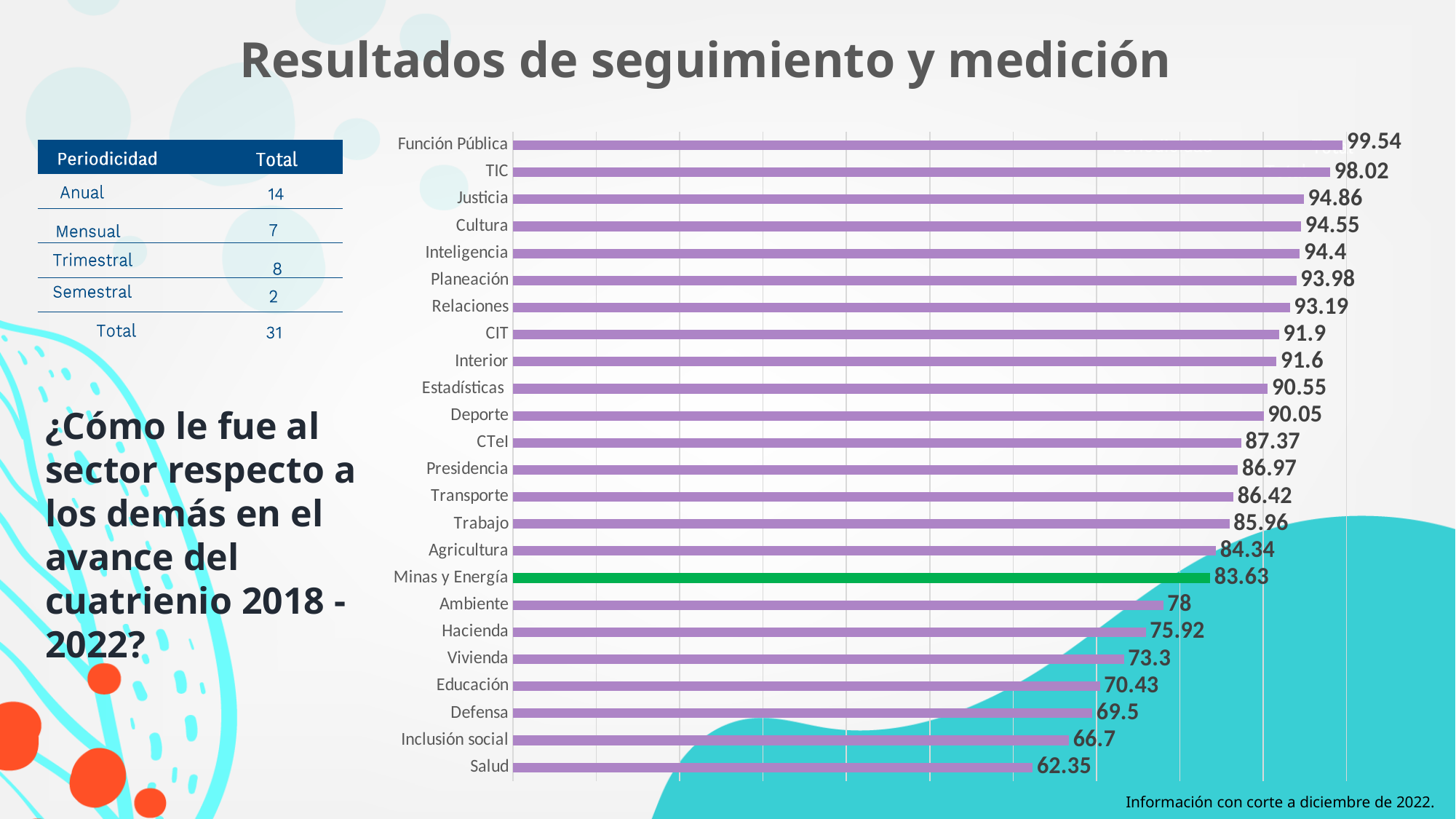
Which bar is highlighted in green rather than purple? Minas y Energía What is the value for Función Pública? 99.54 How many categories are shown in the chart? 24 What is the difference between the values for Función Pública and Salud? 37.19 What kind of chart is shown on the slide? Bar chart Which category has the highest value? Función Pública What is the value for Hacienda? 75.92 Which category has the lowest value? Salud What is the difference between the values for Agricultura and Minas y Energía? 0.71 What is the value for Minas y Energía? 83.63 Which has a larger value, Defensa or Vivienda? Vivienda Which has a larger value, Ambiente or Educación? Ambiente